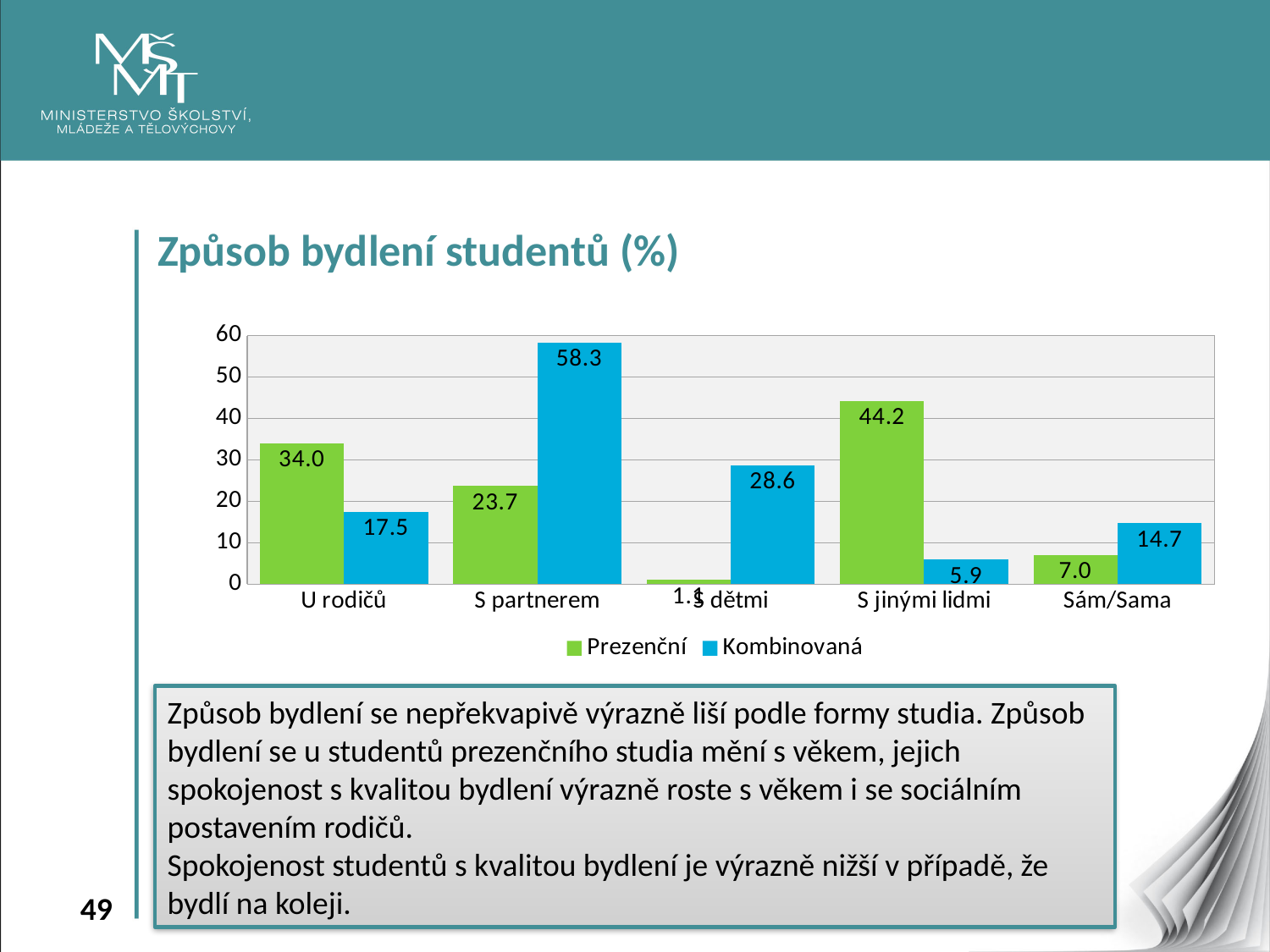
What is the difference between the Kombinovaná and Prezenční values for S partnerem? 34.6 Which category has the highest Prezenční value? S jinými lidmi How many series does the legend list? 2 What type of chart is shown on the slide? bar chart What is the Kombinovaná value for S jinými lidmi? 5.9 Which category has the lowest Kombinovaná value? S jinými lidmi What is the Prezenční value for Sám/Sama? 7.0 Which is larger for U rodičů, the Prezenční value or the Kombinovaná value? Prezenční What is the Prezenční value for U rodičů? 34.0 What is the Kombinovaná value for S partnerem? 58.3 How many categories are shown on the x axis? 5 Is the Kombinovaná value for S dětmi greater or less than 20? greater